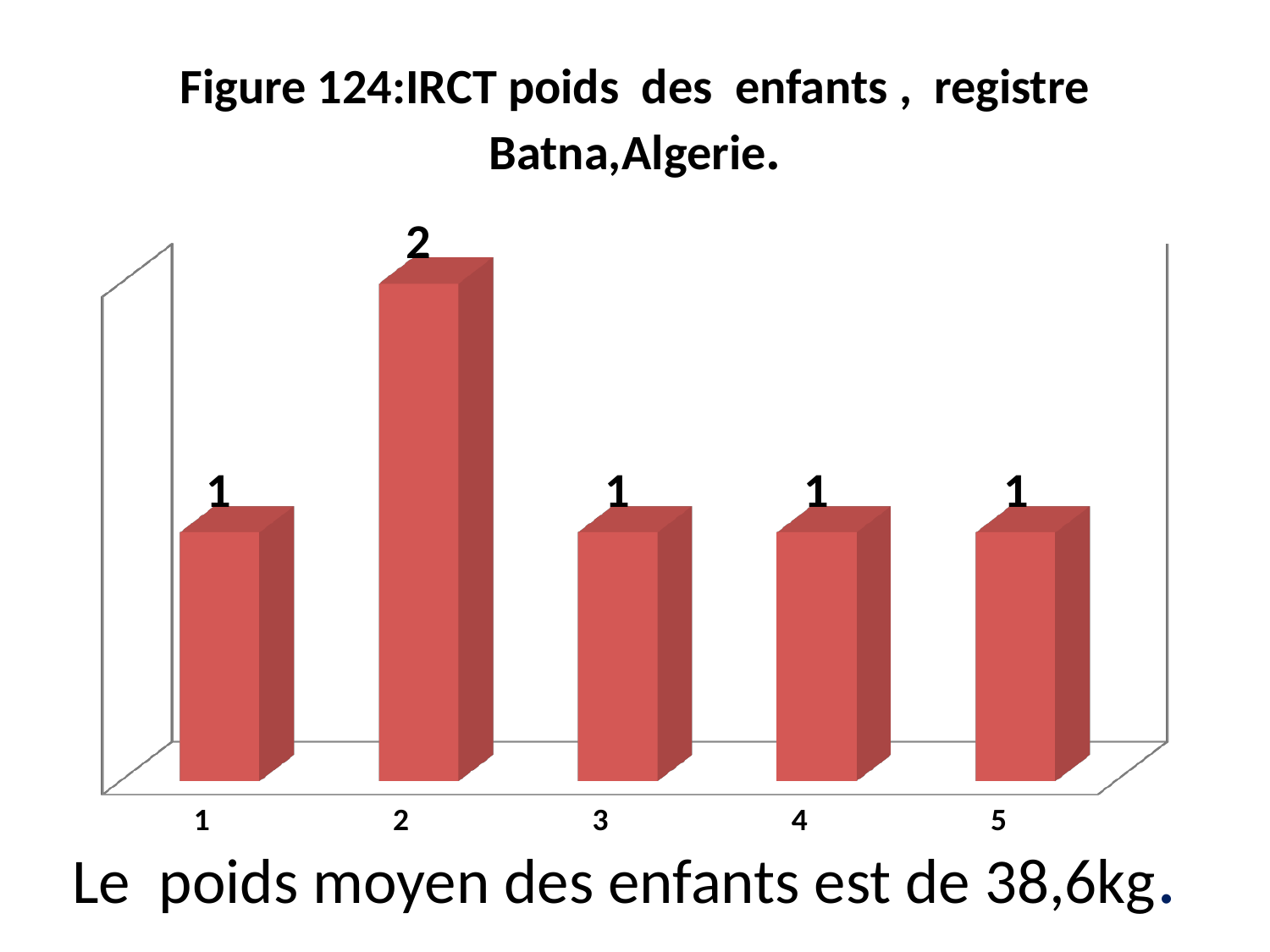
Which category has the highest value? 2 What is the value for category 1? 1 What is the total of the values across all five categories? 6 Which is larger, the value for category 2 or the value for category 4? Category 2 How many categories have a value of 1? 4 How many categories are shown on the x axis? 5 What is the difference between the values for category 2 and category 3? 1 What is the value for category 2? 2 What is the value for category 5? 1 What kind of chart is shown on the slide? Bar chart What is the title of the chart? Figure 124:IRCT poids des enfants , registre Batna,Algerie. What colour are the bars in the chart? Red